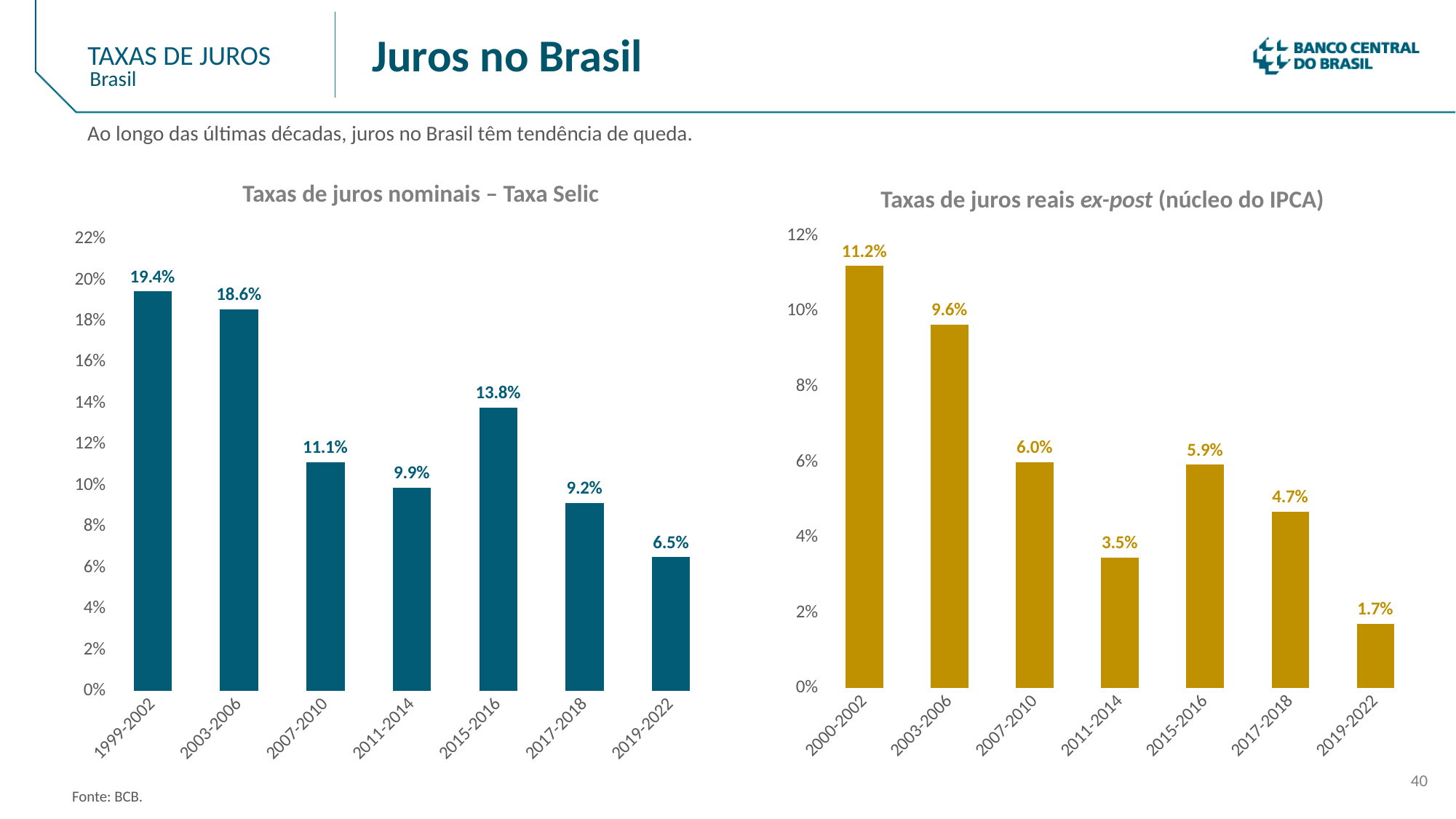
In the chart 'Taxas de juros nominais – Taxa Selic', what is the value for 2015-2016? 13.8% In the chart 'Taxas de juros reais ex-post (núcleo do IPCA)', what is the difference between the values for 2000-2002 and 2003-2006? 1.6% In the chart 'Taxas de juros reais ex-post (núcleo do IPCA)', what is the value for 2011-2014? 3.5% How many periods are shown in the chart 'Taxas de juros nominais – Taxa Selic'? 7 In the chart 'Taxas de juros nominais – Taxa Selic', what is the value for 1999-2002? 19.4% In the chart 'Taxas de juros reais ex-post (núcleo do IPCA)', which period has the lowest value? 2019-2022 In the chart 'Taxas de juros nominais – Taxa Selic', what is the difference between the values for 1999-2002 and 2019-2022? 12.9% What kind of chart is 'Taxas de juros reais ex-post (núcleo do IPCA)'? bar chart In the chart 'Taxas de juros nominais – Taxa Selic', which is larger, the value for 2011-2014 or the value for 2017-2018? 2011-2014 In the chart 'Taxas de juros nominais – Taxa Selic', which period has the highest value? 1999-2002 In the chart 'Taxas de juros nominais – Taxa Selic', do the values generally rise or fall from 1999-2002 to 2019-2022? fall In the chart 'Taxas de juros reais ex-post (núcleo do IPCA)', is the value for 2017-2018 greater or less than 4%? greater